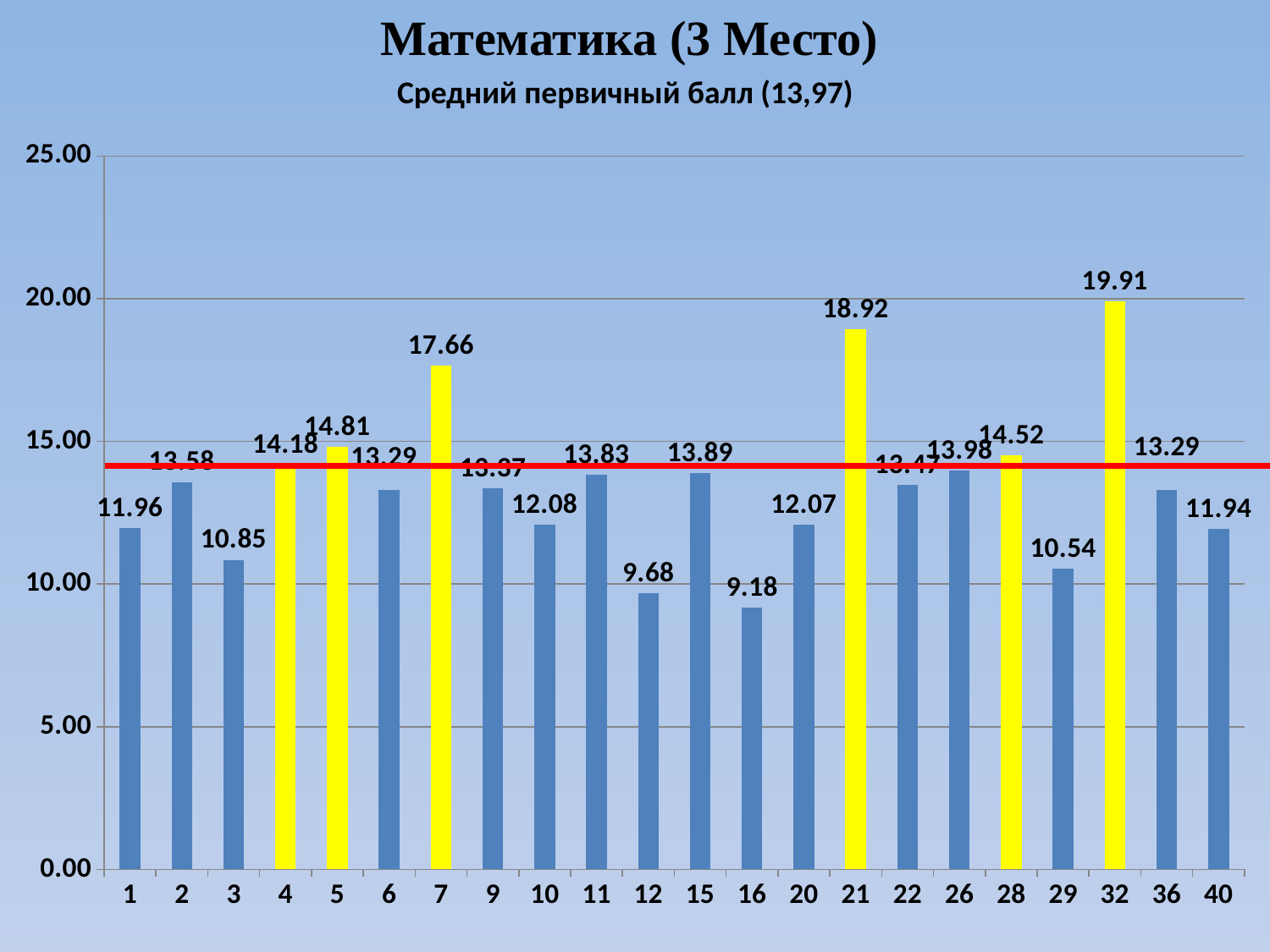
What is the value for category 7? 17.66 What is the difference between the values for category 32 and category 21? 0.99 What kind of chart is shown on the slide? bar chart Is the value for category 3 greater or less than 15.00? less What is the value for category 21? 18.92 How many categories are shown on the x axis? 22 What is the value for category 29? 10.54 What is the value for category 1? 11.96 What colour is the bar for category 32? yellow Which has the larger value, category 12 or category 16? 12 Which category has the lowest value? 16 Which category has the highest value? 32